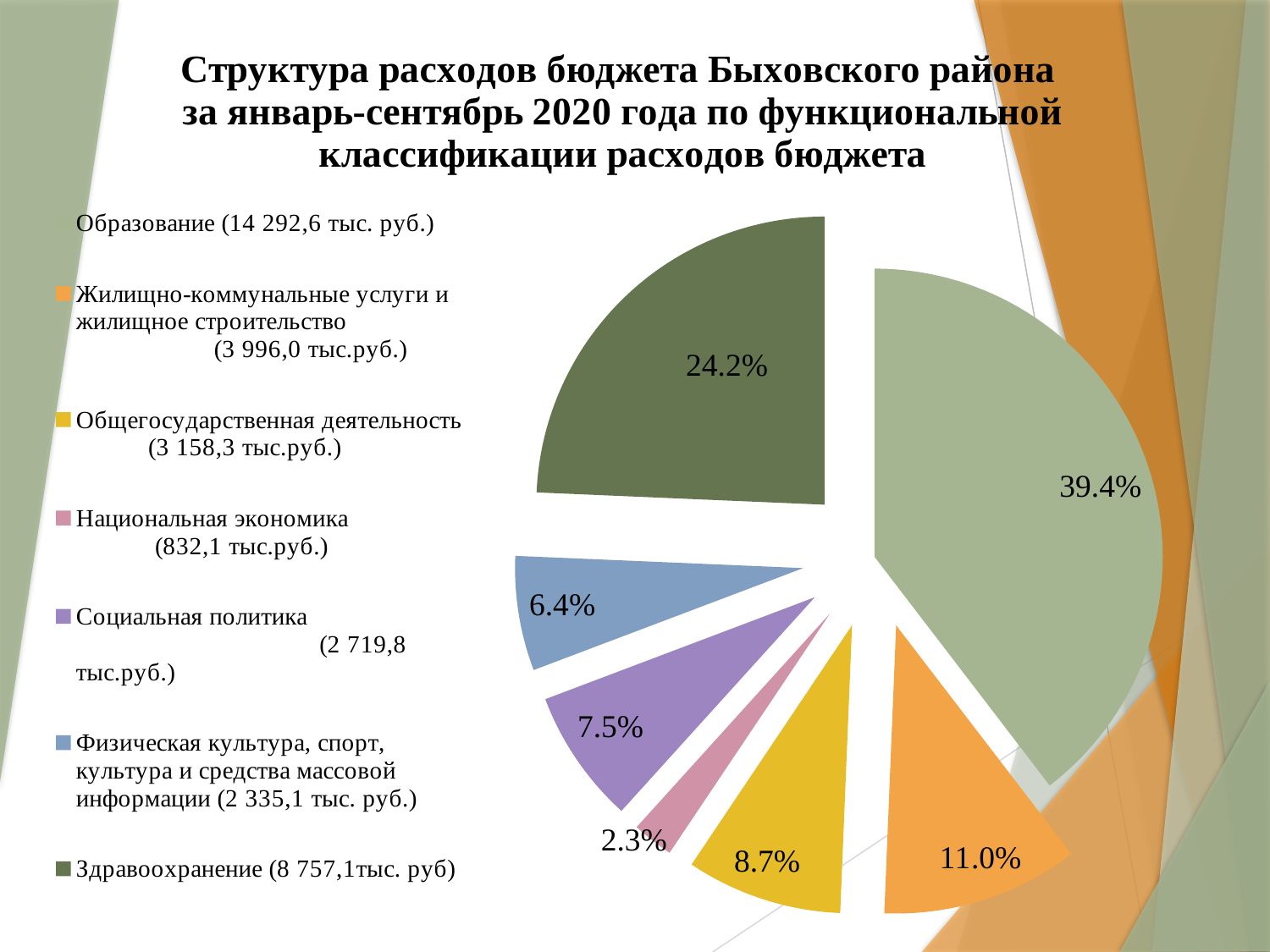
What kind of chart is shown on the slide? pie chart What share of the pie does Общегосударственная деятельность take? 8.7% What share of the pie does Жилищно-коммунальные услуги и жилищное строительство take? 11.0% What share of the pie does Социальная политика take? 7.5% What is the difference in percentage points between the Образование slice and the Здравоохранение slice? 15.2 Which slice is larger: Социальная политика or Физическая культура, спорт, культура и средства массовой информации? Социальная политика Which category has the largest slice of the pie? Образование Which category has the smallest slice of the pie? Национальная экономика How many slices does the pie chart have? 7 According to the legend, what amount in thousand rubles is given for Здравоохранение? 8 757,1 тыс. руб